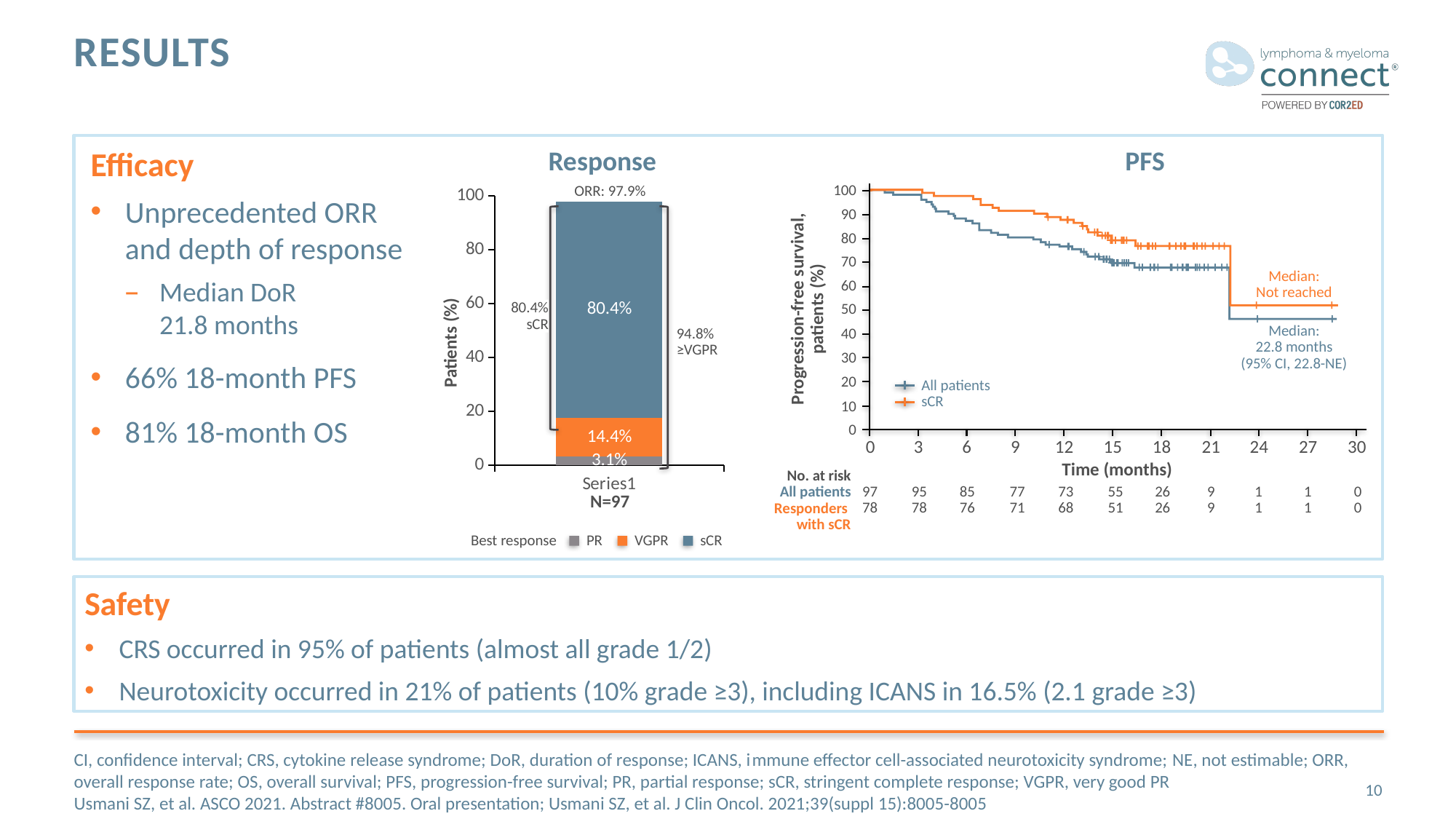
In the Response chart, which best response category has the largest segment? sCR In the Response chart, what is the difference between the sCR and VGPR percentages? 66 percentage points In the Response chart, what percentage of patients achieved VGPR? 14.4% In the Response chart, what is the total of the stacked bar (the ORR)? 97.9% How many best response categories does the legend of the Response chart list? 3 What kind of chart is the Response chart? bar chart In the Response chart, what percentage of patients achieved sCR? 80.4% How many series does the legend of the PFS chart list? 2 In the PFS chart, is the progression-free survival for sCR patients at 12 months greater or less than 80? greater In the Response chart, what percentage of patients achieved PR? 3.1% What kind of chart is the PFS chart? line chart In the PFS chart, which curve is higher at 12 months, All patients or sCR? sCR